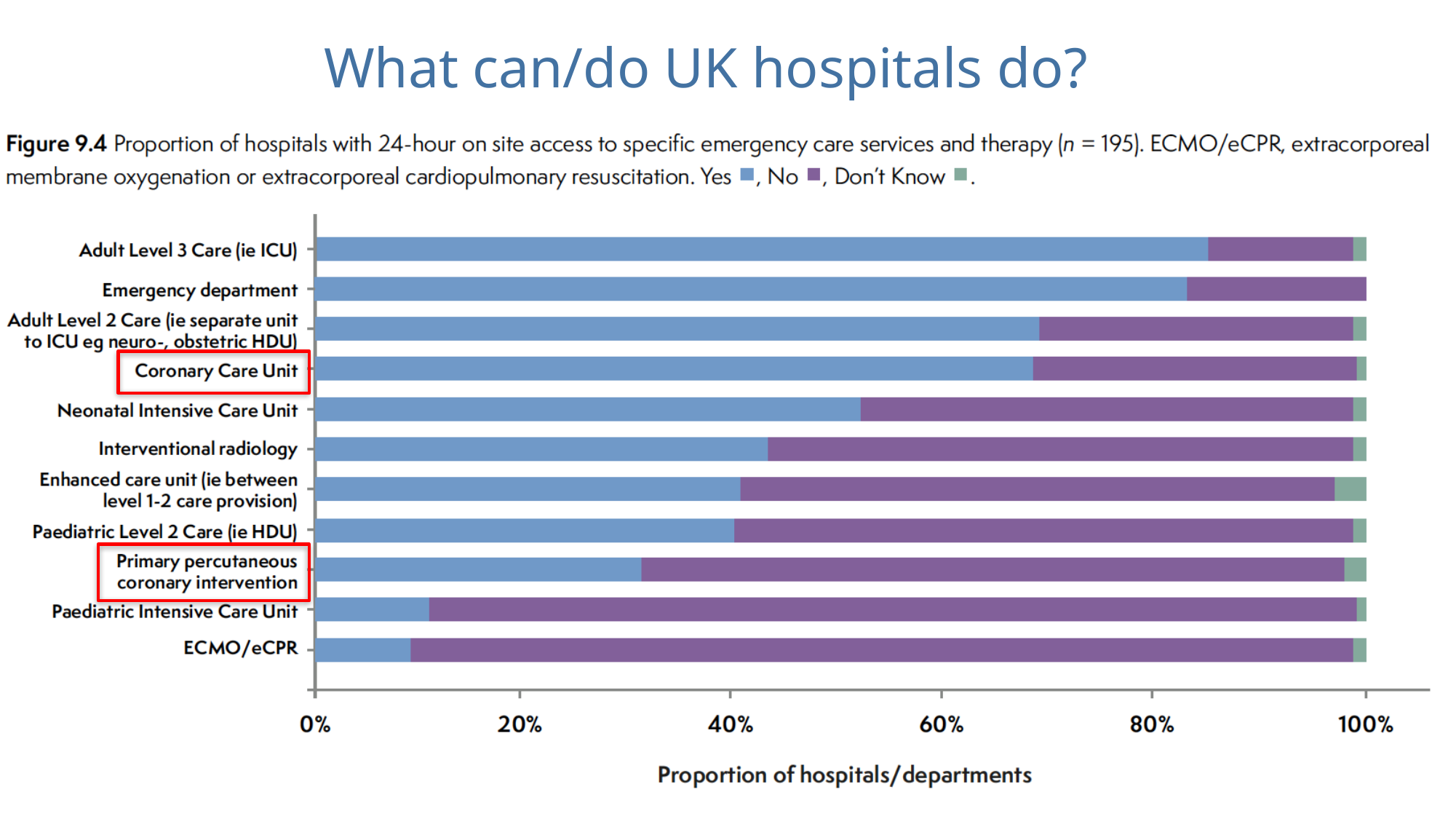
Is the 'Yes' proportion for Primary percutaneous coronary intervention greater or less than 40%? less Which has a larger 'Yes' proportion: Neonatal Intensive Care Unit or ECMO/eCPR? Neonatal Intensive Care Unit Is the 'Yes' proportion for Paediatric Intensive Care Unit greater or less than 20%? less What is the title of the x axis? Proportion of hospitals/departments How many categories (services) are plotted in the chart? 11 How many series does the legend list? 3 Which service has the highest 'Yes' proportion? Adult Level 3 Care (ie ICU) Which has a larger 'Yes' proportion: Coronary Care Unit or Primary percutaneous coronary intervention? Coronary Care Unit Is the 'Yes' proportion for Adult Level 3 Care (ie ICU) greater or less than 80%? greater What kind of chart is shown on the slide? Stacked bar chart Which service has the lowest 'Yes' proportion? ECMO/eCPR